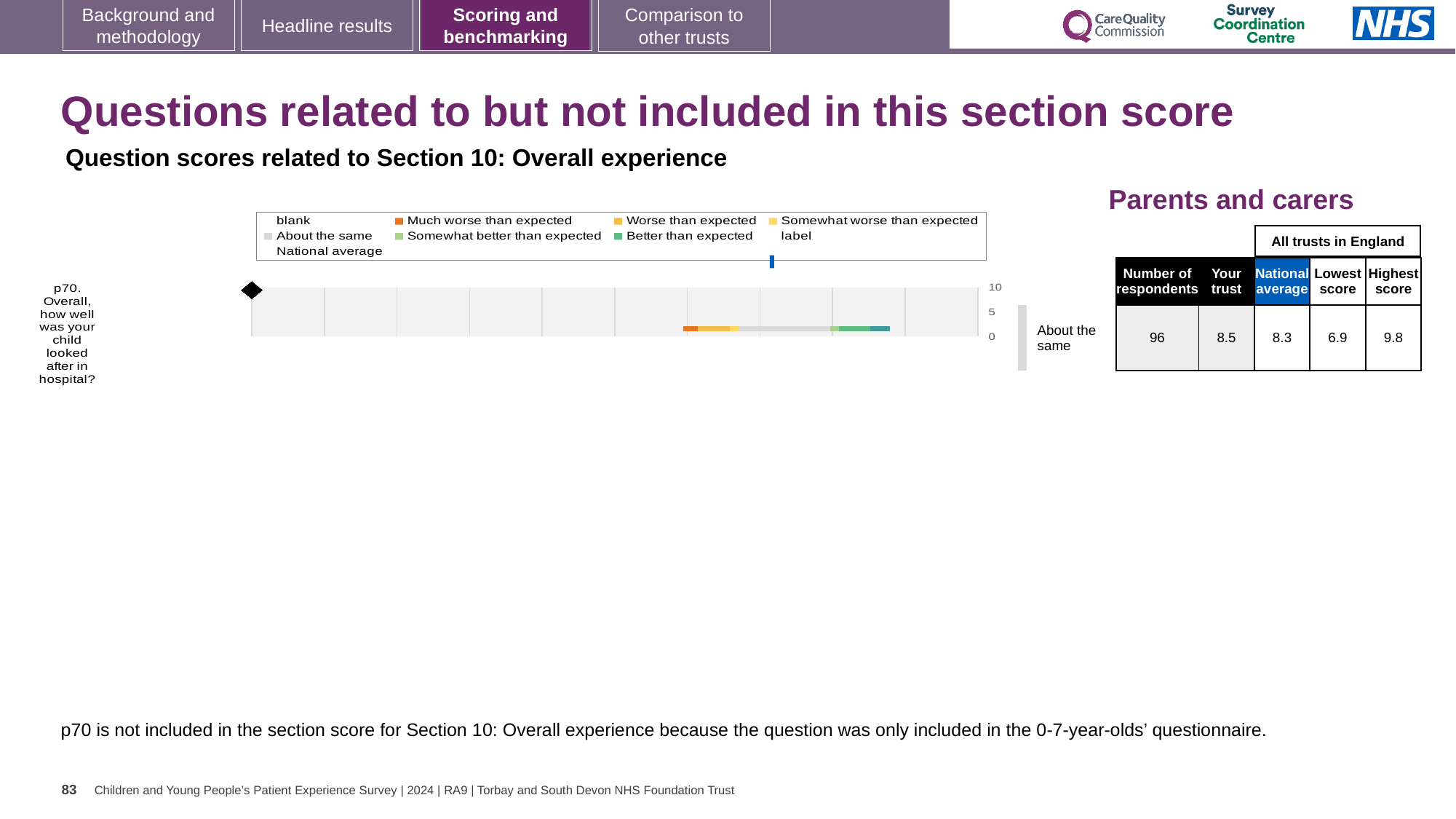
What colour represents 'Much worse than expected' in the chart legend? orange What is the difference between the highest and lowest trust scores for p70? 2.9 How many questions are plotted in the chart? 1 What kind of chart is used to show the p70 question score? bar chart What is the highest score among all trusts in England for p70? 9.8 How many respondents answered p70? 96 Which is larger for p70, the 'Your trust' score or the national average? Your trust What is the national average score for p70? 8.3 What is the 'Your trust' score for p70 in the Parents and carers table? 8.5 What benchmark category is the trust's p70 score placed in, according to the label next to the chart? About the same What is the lowest score among all trusts in England for p70? 6.9 What is the difference between the 'Your trust' score and the national average for p70? 0.2